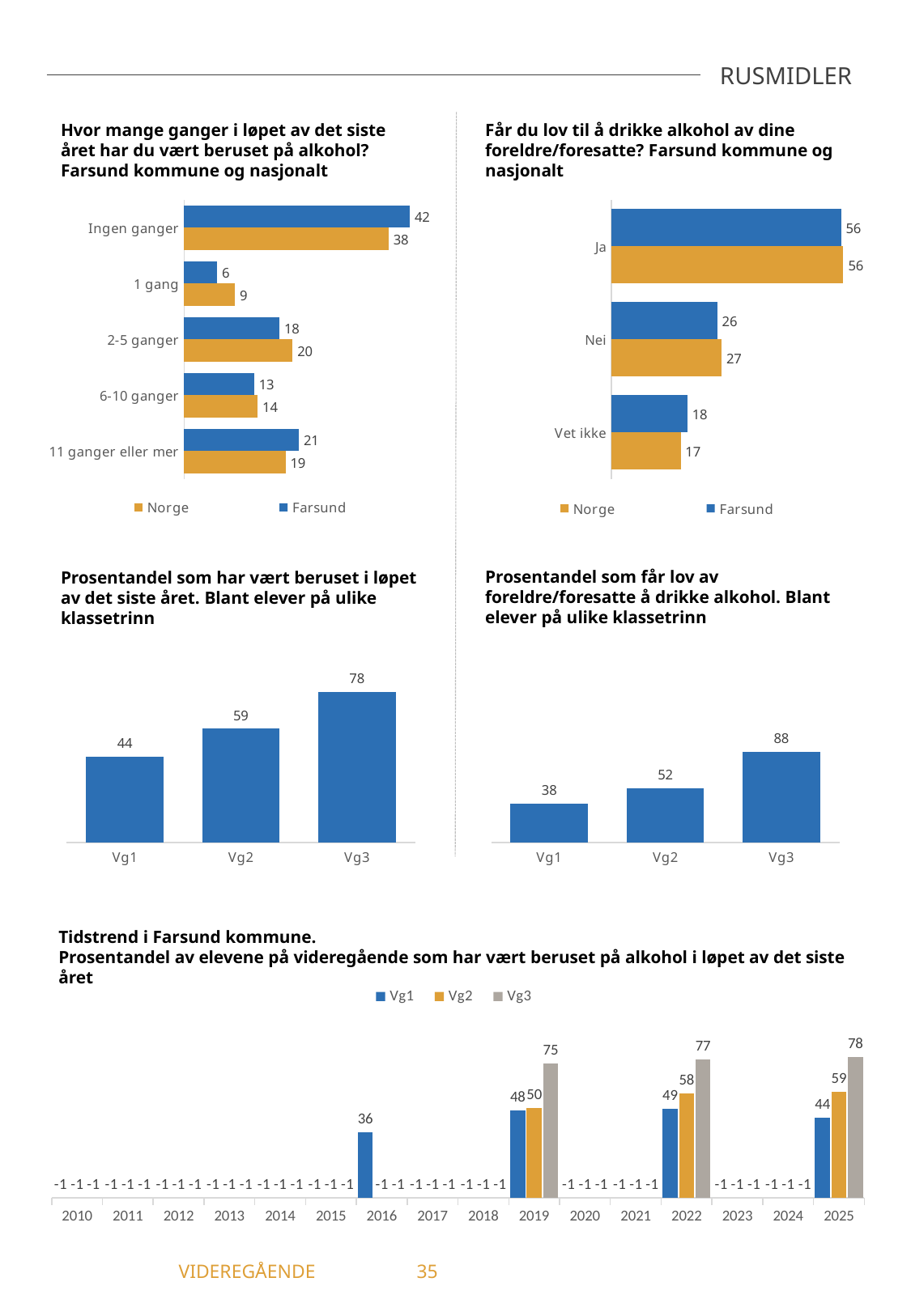
In the middle-right chart 'Prosentandel som får lov av foreldre/foresatte å drikke alkohol', what is the difference between Vg3 and Vg1? 50 In the top-left chart 'Hvor mange ganger i løpet av det siste året har du vært beruset på alkohol?', how many categories are shown? 5 In the bottom chart 'Tidstrend i Farsund kommune', what is the Vg3 value for 2022? 77 In the middle-left chart 'Prosentandel som har vært beruset i løpet av det siste året', what is the value for Vg2? 59 In the top-left chart 'Hvor mange ganger i løpet av det siste året har du vært beruset på alkohol?', what is the Farsund value for 'Ingen ganger'? 42 In the top-left chart 'Hvor mange ganger i løpet av det siste året har du vært beruset på alkohol?', what is the difference between the Norge and Farsund values for '1 gang'? 3 In the middle-right chart 'Prosentandel som får lov av foreldre/foresatte å drikke alkohol', what kind of chart is it? bar chart In the top-right chart 'Får du lov til å drikke alkohol av dine foreldre/foresatte?', how many series does the legend list? 2 In the top-right chart 'Får du lov til å drikke alkohol av dine foreldre/foresatte?', what is the Norge value for 'Nei'? 27 In the middle-left chart 'Prosentandel som har vært beruset i løpet av det siste året', do the values rise or fall from Vg1 to Vg3? rise In the top-right chart 'Får du lov til å drikke alkohol av dine foreldre/foresatte?', which category has the highest Farsund value? Ja In the bottom chart 'Tidstrend i Farsund kommune', which is larger in 2025: Vg1 or Vg2? Vg2